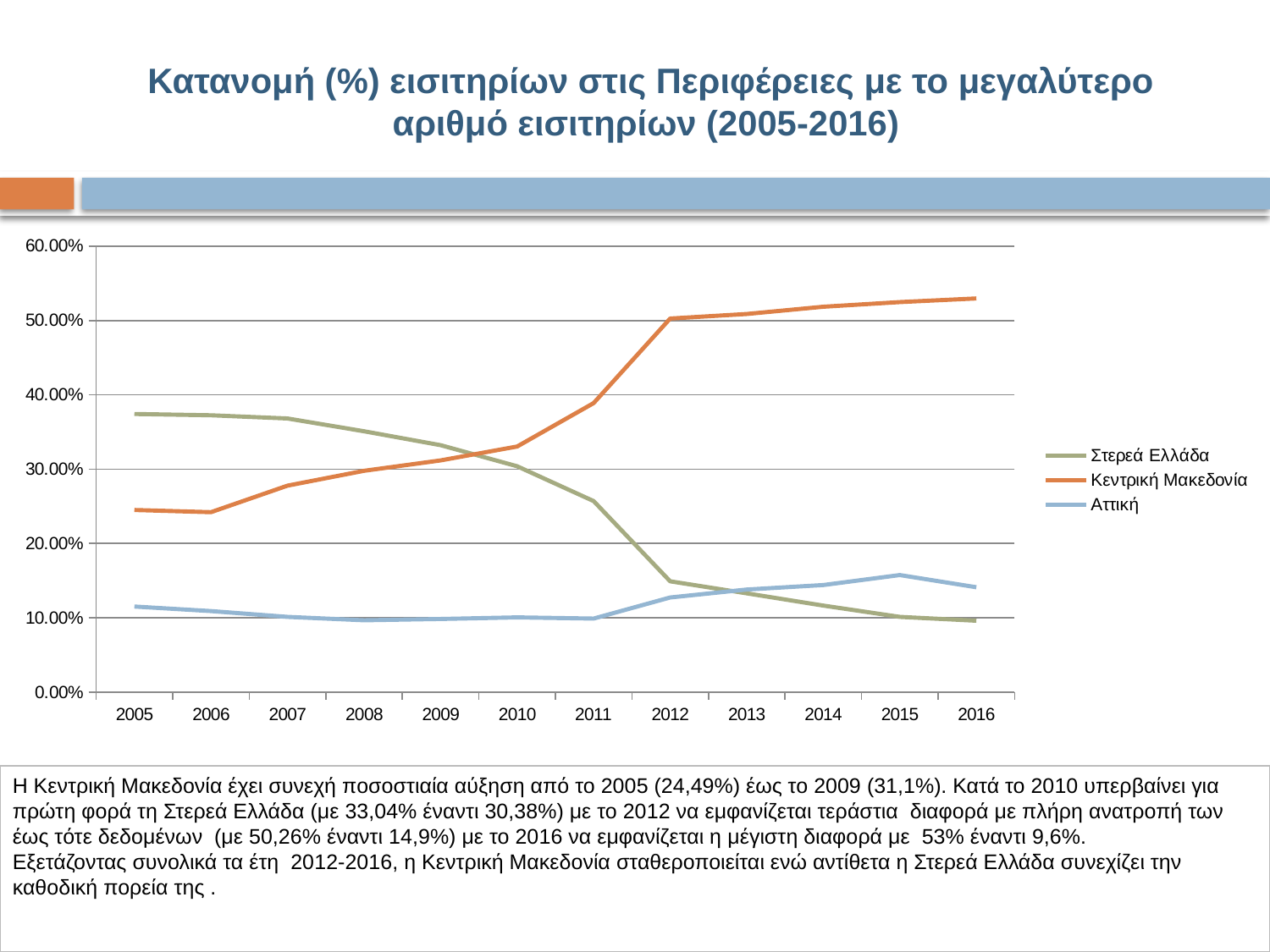
Which series has the highest value in 2016? Κεντρική Μακεδονία Does the value for Κεντρική Μακεδονία rise or fall from 2005 to 2016? rise How many series does the legend list? 3 Is the value for Κεντρική Μακεδονία in 2012 greater or less than 40.00%? greater Which series has the highest value in 2005? Στερεά Ελλάδα Is the value for Αττική in 2008 greater or less than 20.00%? less Which series has the lowest value in 2016? Στερεά Ελλάδα What colour is the line for Αττική in the legend? blue Does the value for Στερεά Ελλάδα rise or fall from 2005 to 2016? fall What kind of chart is shown on the slide? line chart How many years are shown on the x axis? 12 In 2011, which is larger: the value for Κεντρική Μακεδονία or the value for Στερεά Ελλάδα? Κεντρική Μακεδονία